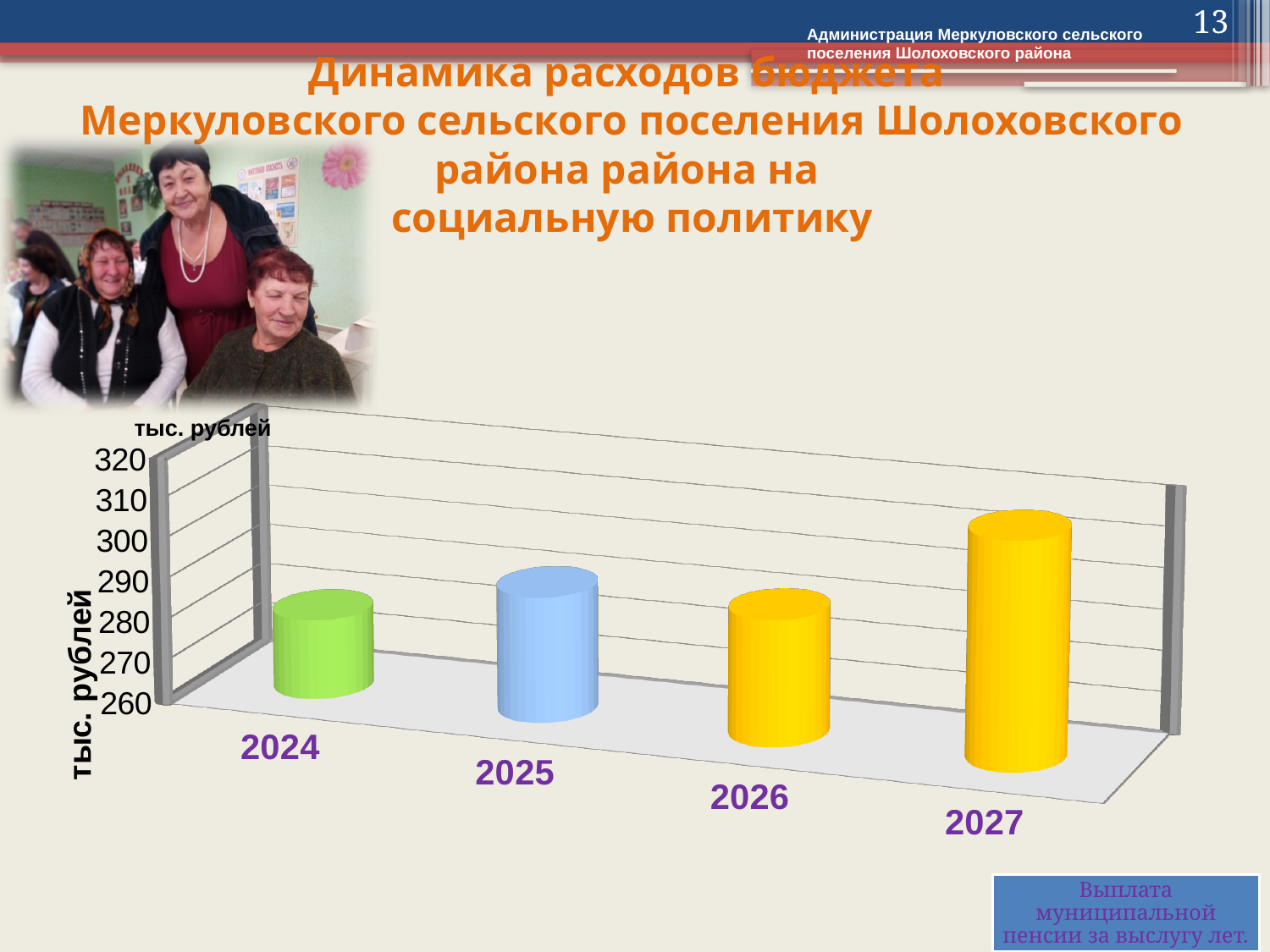
Is the value for 2026 greater or less than 300? less Which is larger, the value for 2025 or the value for 2024? 2025 Which year has the highest value in the chart? 2027 Is the value for 2027 greater or less than 280? greater What unit is given on the vertical axis of the chart? тыс. рублей What kind of chart is shown on the slide? bar chart Is the value for 2024 greater or less than 300? less What colour is the bar for 2024? green Which is larger, the value for 2027 or the value for 2024? 2027 How many years are shown on the x axis of the chart? 4